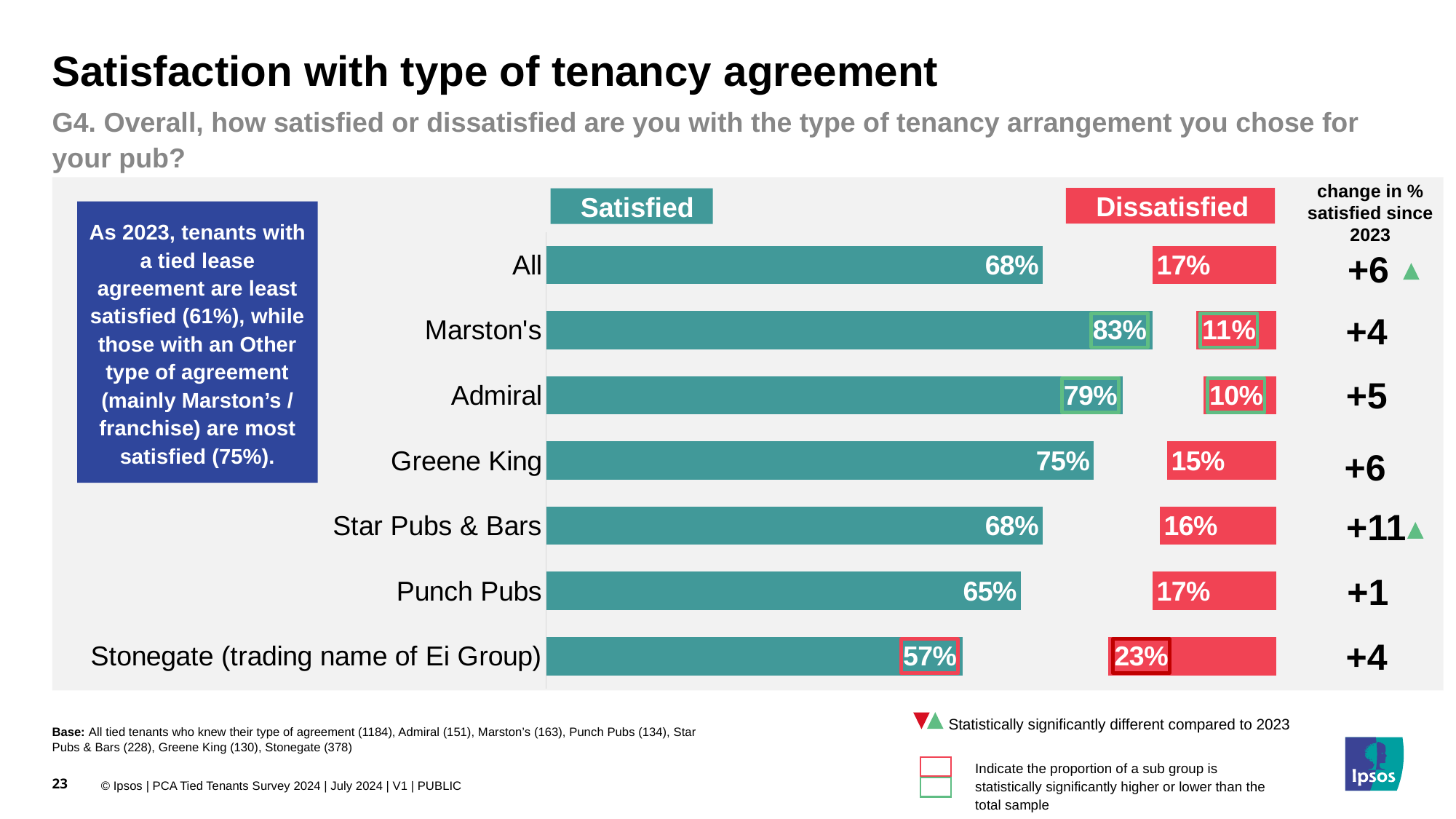
What is the change in % satisfied since 2023 for Star Pubs & Bars? +11 How many series does the chart show? 2 Which category has the lowest Satisfied percentage? Stonegate (trading name of Ei Group) How many categories are shown on the chart? 7 What kind of chart is shown on the slide? Bar chart Which has a higher Dissatisfied percentage, Star Pubs & Bars or Punch Pubs? Punch Pubs What is the difference between the Satisfied percentages for Marston's and Punch Pubs? 18 percentage points Which pub company has the highest Satisfied percentage? Marston's What is the Satisfied value for Greene King? 75% Which category has the lowest Dissatisfied percentage? Admiral What is the Dissatisfied value for Stonegate (trading name of Ei Group)? 23% What percentage of Marston's tenants are satisfied with their type of tenancy agreement? 83%